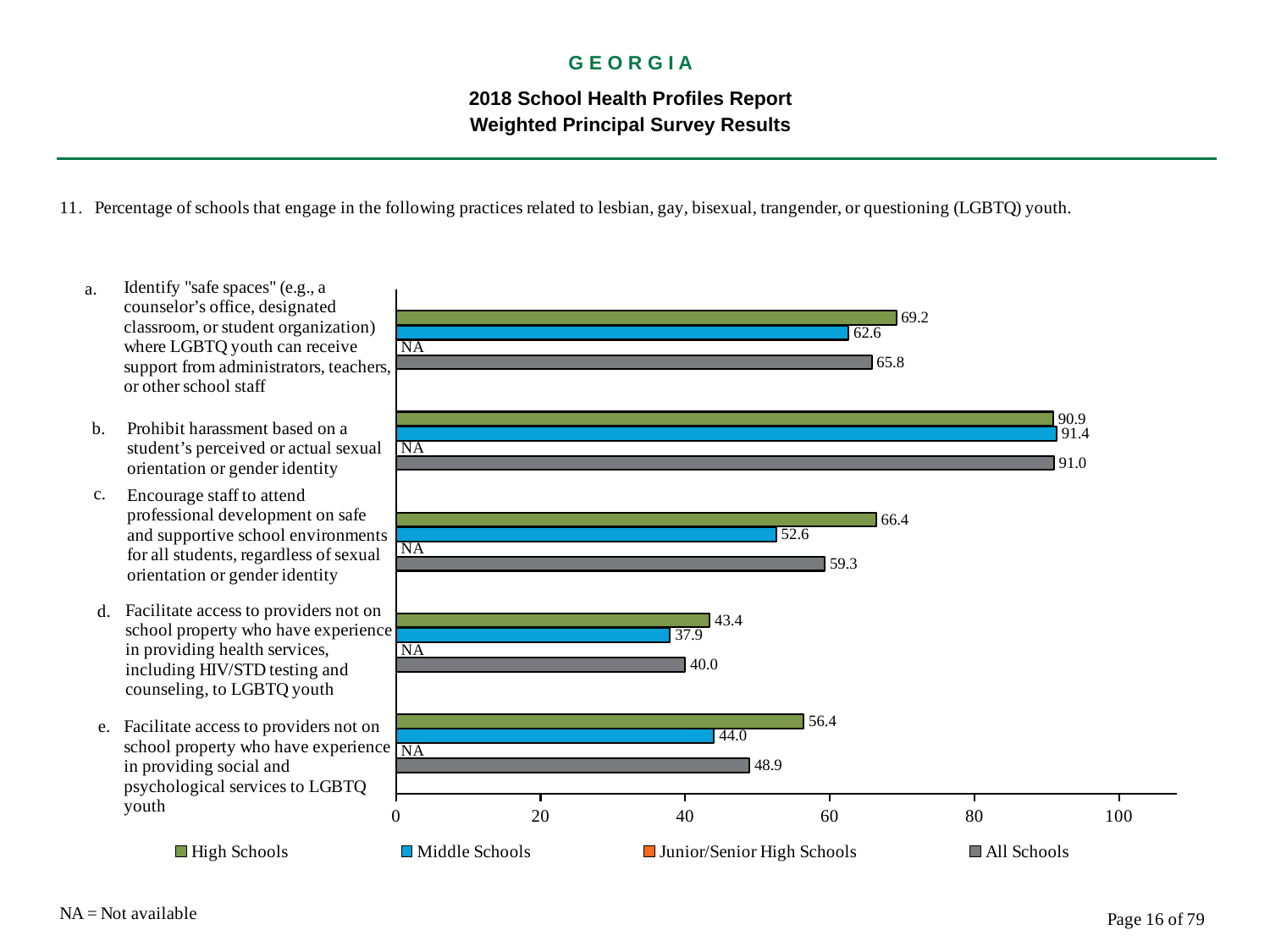
How many practices (categories) are shown on the chart? 5 What kind of chart is shown on the slide? Bar chart What value is shown for Junior/Senior High Schools for practice a (identify "safe spaces")? NA What is the Middle Schools value for practice c (encourage staff to attend professional development on safe and supportive school environments)? 52.6 Is the All Schools value for practice c (encourage staff to attend professional development) greater or less than 60? less For practice a (identify "safe spaces"), which is larger: the High Schools value or the Middle Schools value? High Schools Which practice has the highest All Schools value? b. Prohibit harassment based on a student's perceived or actual sexual orientation or gender identity What is the All Schools value for practice d (facilitate access to providers not on school property who provide health services, including HIV/STD testing)? 40.0 How many series does the legend list? 4 What is the difference between the High Schools and Middle Schools values for practice e (facilitate access to providers of social and psychological services)? 12.4 Which practice has the lowest Middle Schools value? d. Facilitate access to providers not on school property who have experience in providing health services, including HIV/STD testing and counseling, to LGBTQ youth What is the High Schools value for practice b (prohibit harassment based on a student's perceived or actual sexual orientation or gender identity)? 90.9